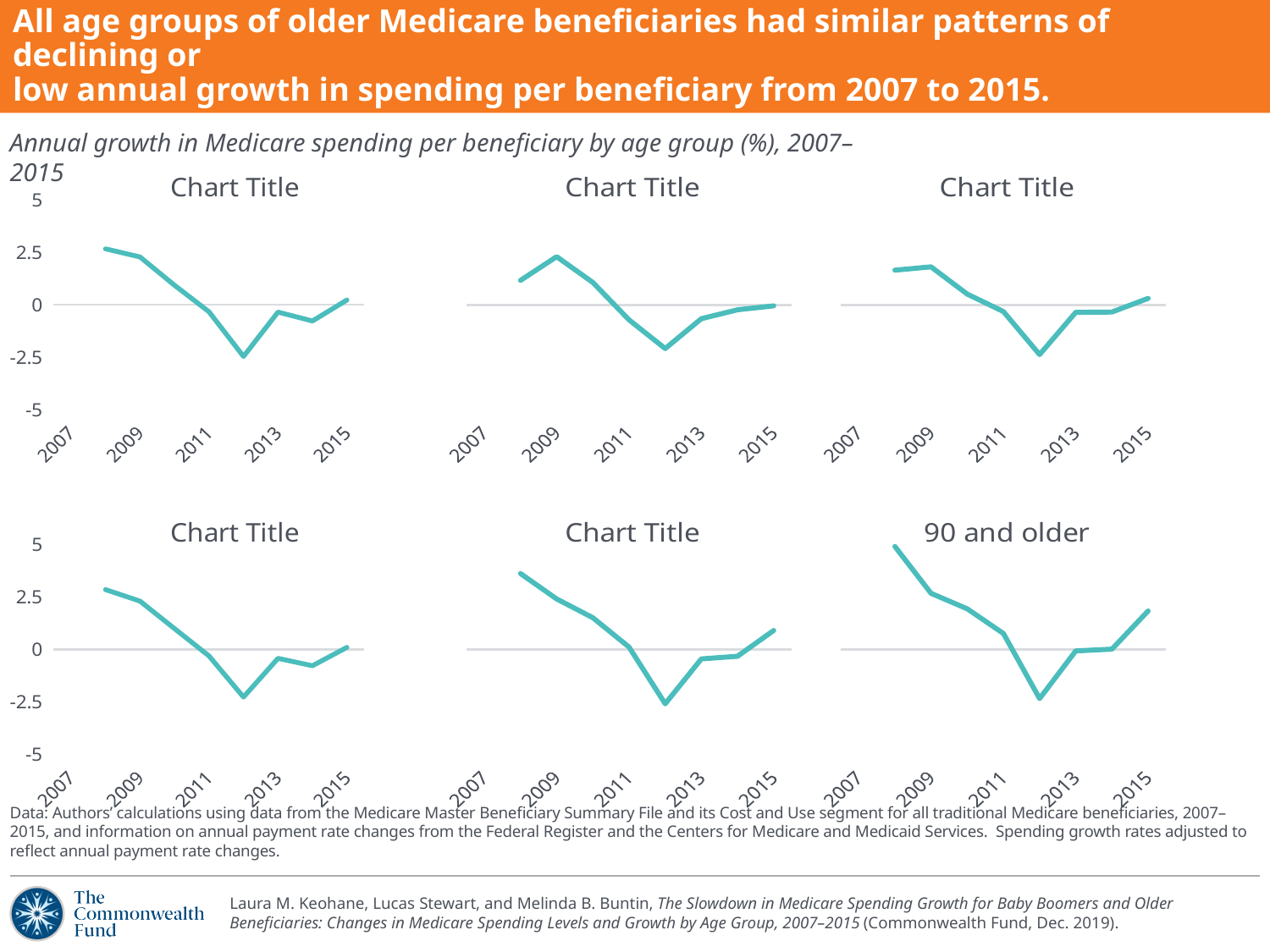
In the bottom-middle chart, is the value for 2015 greater or less than 0? greater What kind of chart is the bottom-right chart titled '90 and older'? line chart In the '90 and older' chart, is the value for 2012 greater or less than 0? less In the top-left chart, is the value for 2012 greater or less than 0? less In the '90 and older' chart, which year has the lowest value? 2012 In the top-left chart, do the values rise or fall from 2009 to 2012? fall How many charts are shown on the slide? 6 What is the title of the bottom-right chart? 90 and older What is the highest tick value shown on the y axis of the charts? 5 In the '90 and older' chart, which is larger, the value for 2015 or the value for 2012? 2015